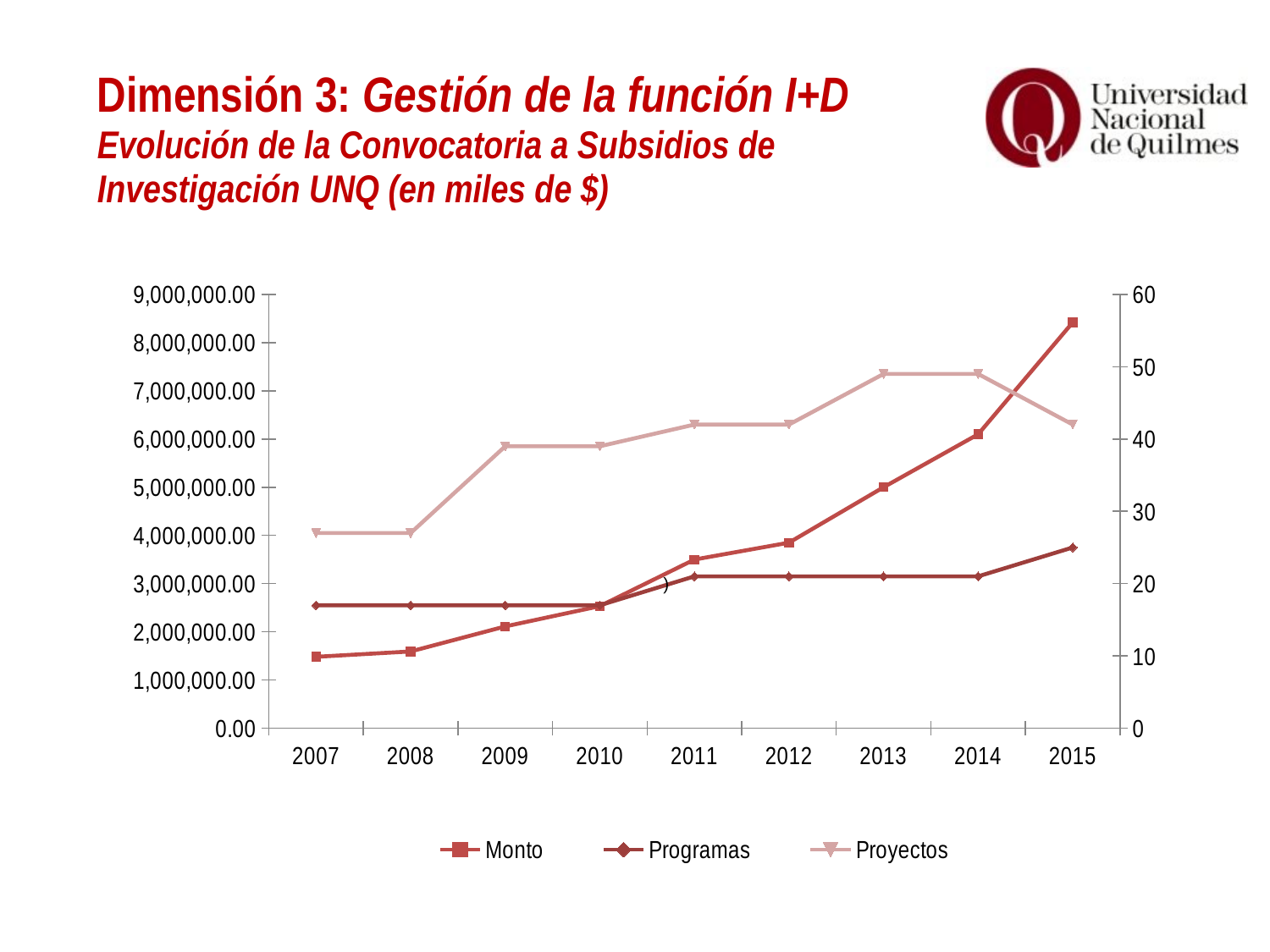
How many series does the legend list? 3 What kind of chart is shown on the slide? line chart Is the Monto value for 2007 greater or less than 2,000,000.00? less Does the Monto series rise or fall from 2007 to 2015? rise In which year is the Monto series at its highest? 2015 Is the Programas value for 2007 greater or less than 20 on the right axis? less Which year has the larger Proyectos value, 2014 or 2015? 2014 What are the three series named in the legend? Monto, Programas, Proyectos Is the Proyectos value for 2013 greater or less than 40 on the right axis? greater In which year is the Monto series at its lowest? 2007 How many years are plotted along the x axis? 9